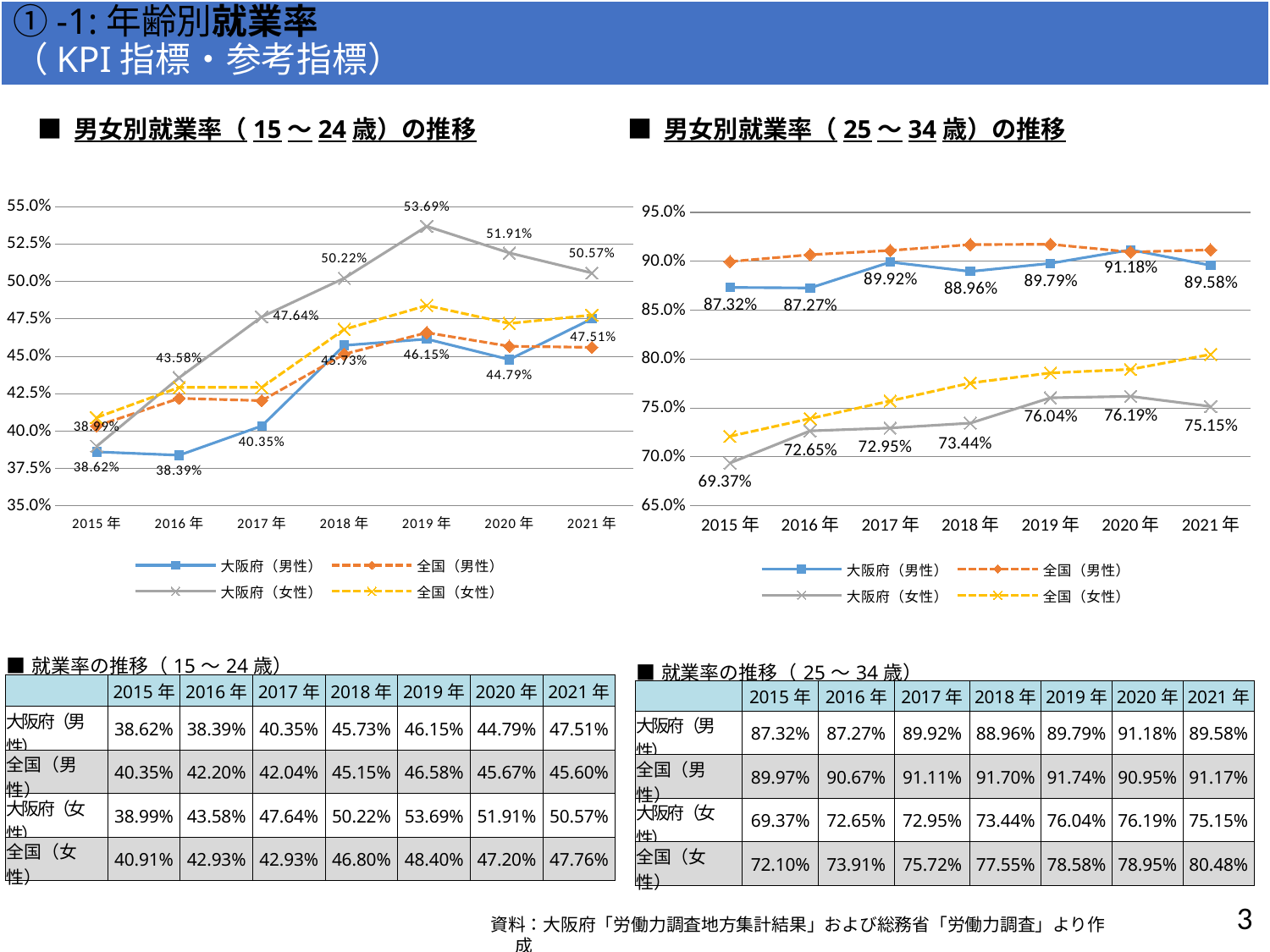
In the right chart (25～34歳), in which year is the 大阪府（女性） value lowest? 2015年 What kind of chart is the left chart titled 男女別就業率（15～24歳）の推移? Line chart In the left chart (15～24歳), by how many percentage points did 大阪府（男性） increase from 2015年 to 2021年? 8.89 percentage points In the left chart (15～24歳), is the value for 大阪府（男性） in 2016年 greater or less than 40.0%? Less In the left chart (15～24歳), in which year is the 大阪府（女性） value highest? 2019年 How many years are plotted on the x axis of the left chart (15～24歳)? 7 How many series does the legend of the right chart (25～34歳) list? 4 In the left chart (15～24歳), what is the value for 大阪府（女性） in 2019年? 53.69% In the right chart (25～34歳), which is larger in 2021年: 大阪府（男性） or 全国（男性）? 全国（男性） In the right chart (25～34歳), does the 大阪府（女性） line rise or fall overall from 2015年 to 2021年? Rise In the right chart (25～34歳), what is the value for 大阪府（男性） in 2020年? 91.18% In the right chart (25～34歳), what is the difference between the 大阪府（女性） values in 2021年 and 2015年? 5.78 percentage points